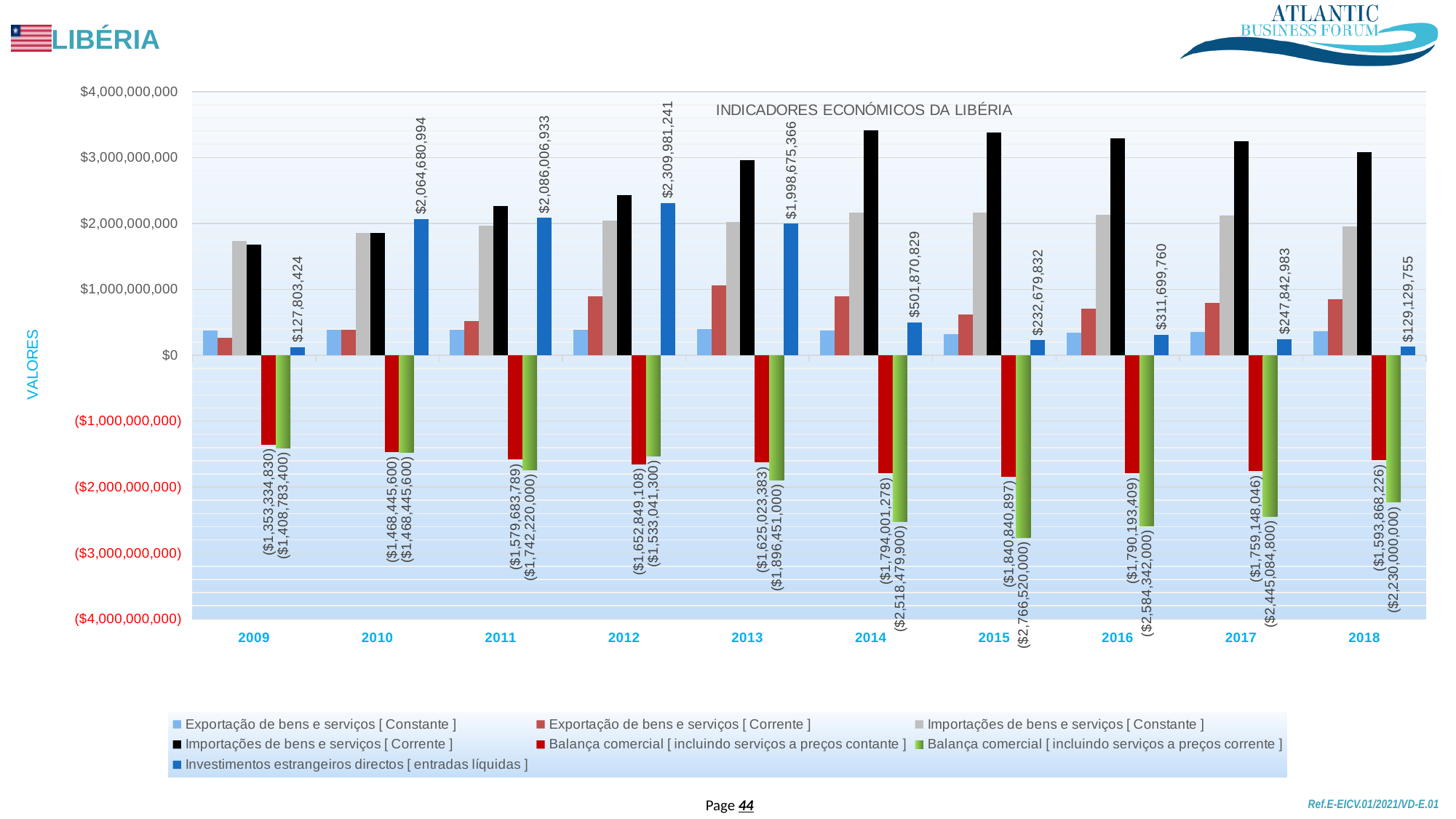
In which year is Investimentos estrangeiros directos [entradas líquidas] highest? 2012 Is the value of Importações de bens e serviços [Corrente] in 2014 greater or less than $3,000,000,000? greater What is the value of Investimentos estrangeiros directos [entradas líquidas] in 2012? $2,309,981,241 How many series does the legend list? 7 Which year has the larger value of Investimentos estrangeiros directos, 2010 or 2013? 2010 What is the value of Balança comercial [incluindo serviços a preços corrente] in 2015? ($2,766,520,000) How many years are shown on the x axis of the chart? 10 What type of chart is shown on the slide? bar chart In which year is Investimentos estrangeiros directos [entradas líquidas] lowest? 2009 What is the value of Balança comercial [incluindo serviços a preços contante] in 2009? ($1,353,334,830) What is the difference between Investimentos estrangeiros directos in 2012 and in 2011? $223,974,308 What is the title of the chart? INDICADORES ECONÓMICOS DA LIBÉRIA